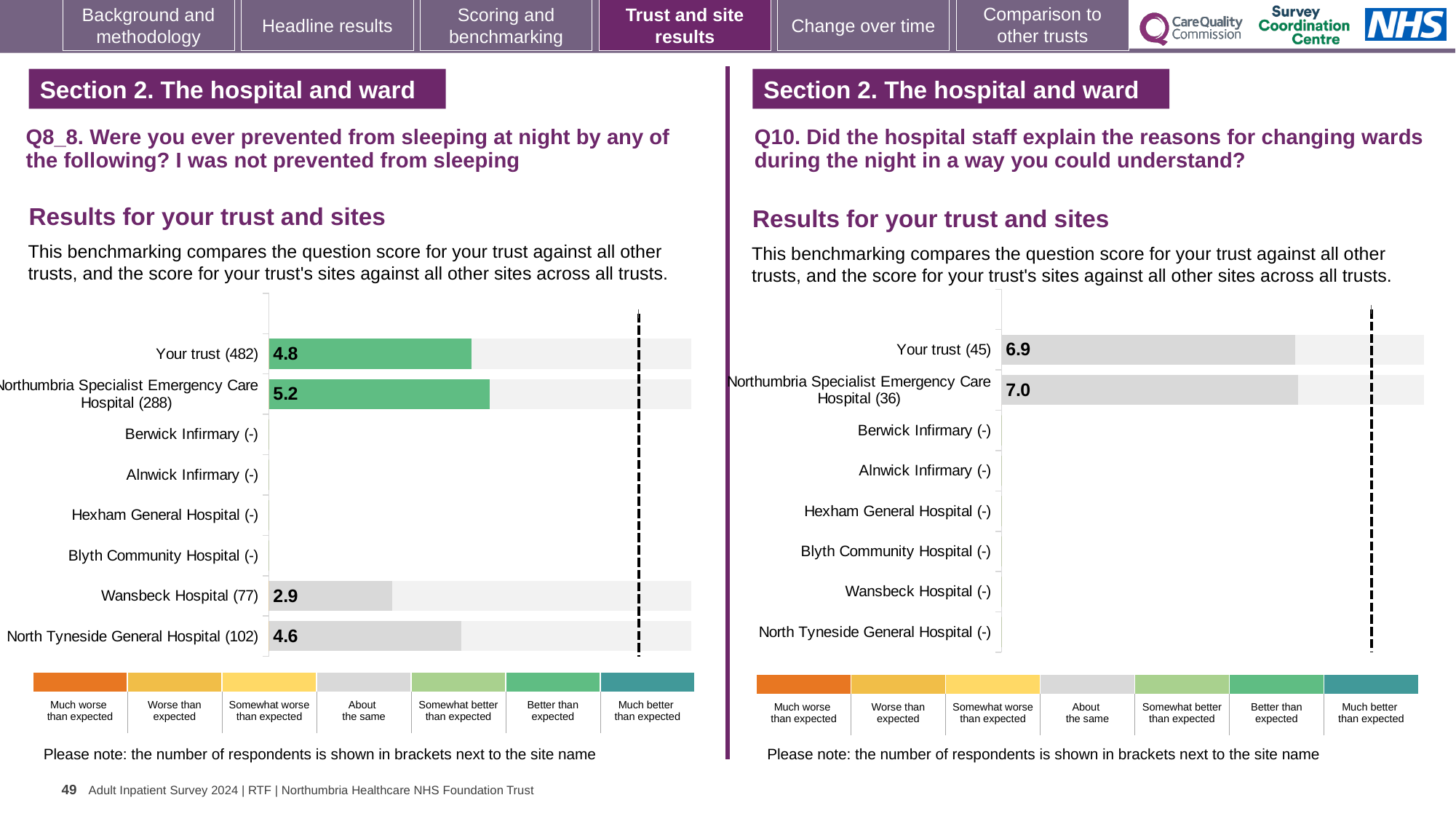
On the Q8_8 chart (left), what is the score for North Tyneside General Hospital? 4.6 On the Q8_8 chart (left), which site has the lowest score? Wansbeck Hospital On the Q10 chart (right), what is the score for Your trust? 6.9 On the Q8_8 chart (left), what is the difference between the scores for Northumbria Specialist Emergency Care Hospital and Wansbeck Hospital? 2.3 On the Q8_8 chart (left), which site has the highest score? Northumbria Specialist Emergency Care Hospital On the Q8_8 chart (left), what is the score for Your trust? 4.8 On the Q8_8 chart (left), what is the score for Wansbeck Hospital? 2.9 What kind of chart is used on the Q8_8 chart (left)? Bar chart On the Q8_8 chart (left), how many sites have a score bar plotted (excluding Your trust)? 3 On the Q8_8 chart (left), which has a higher score: Your trust or North Tyneside General Hospital? Your trust On the Q10 chart (right), how many respondents are shown for Your trust? 45 On the Q10 chart (right), what is the score for Northumbria Specialist Emergency Care Hospital? 7.0